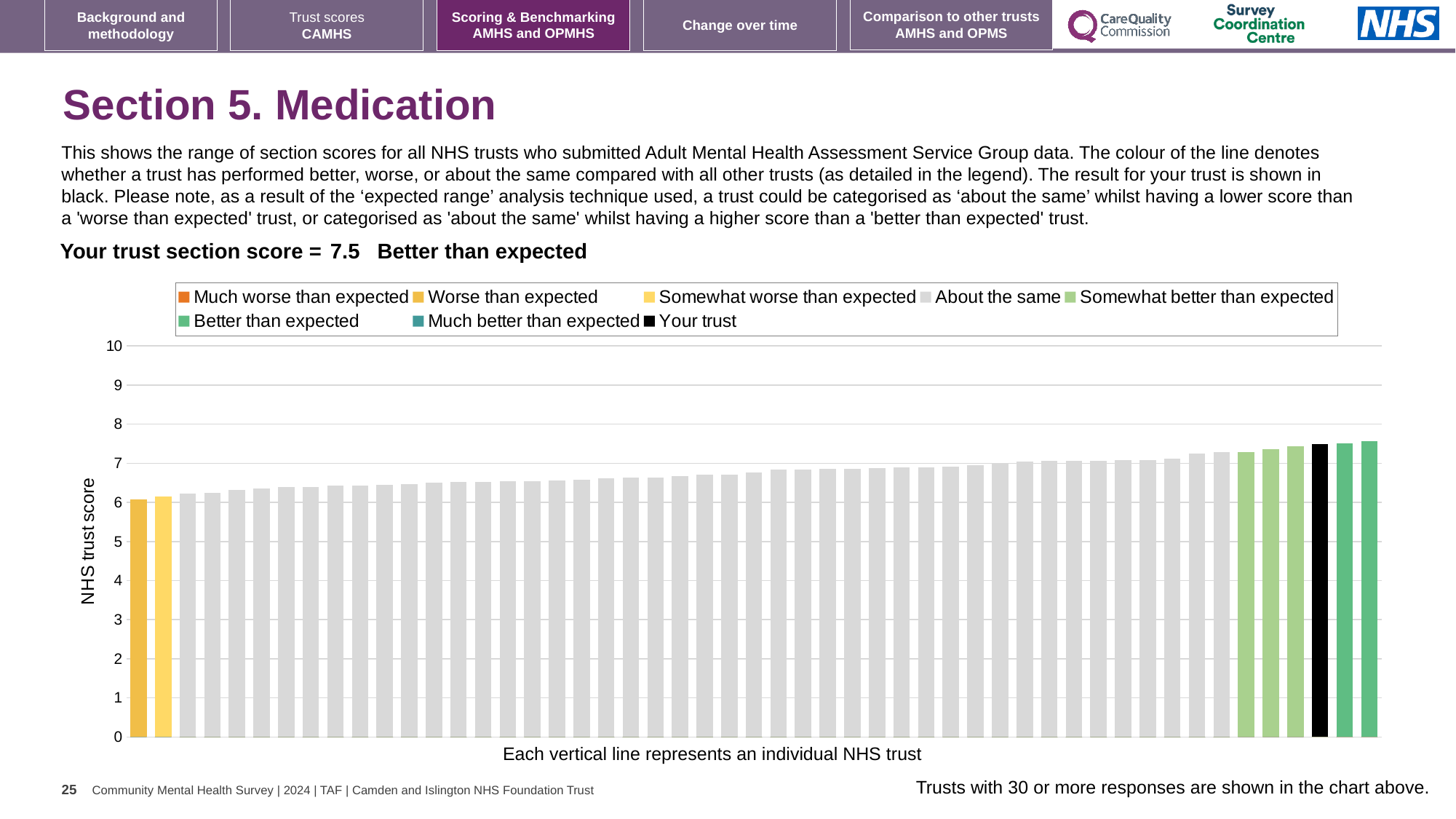
Is the value of the leftmost (lowest) bar greater or less than 7? less What is the label on the vertical axis of the chart? NHS trust score What colour is the bar representing your trust? black Is the value for your trust greater or less than 7? greater How many entries does the chart legend list? 8 Do the bar values rise or fall from left to right along the x axis? rise What kind of chart is shown on the slide? bar chart Is the value for your trust greater or less than 8? less Which category is your trust's section score placed in? Better than expected What is the section score for your trust? 7.5